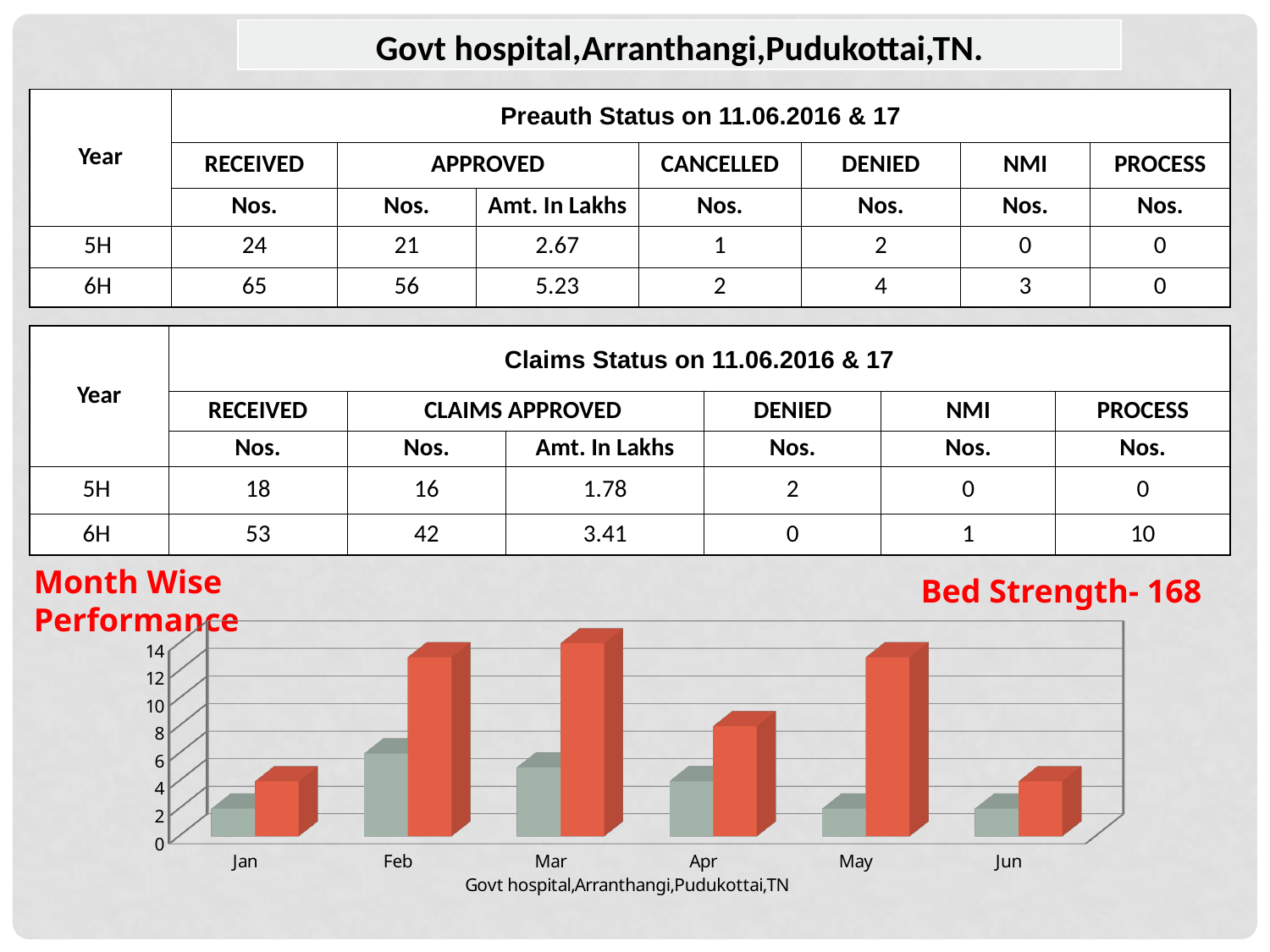
In the Month Wise Performance chart, is the red bar for Jan greater or less than 6? less In the Month Wise Performance chart, is the red bar for May greater or less than 10? greater In the Month Wise Performance chart, is the red bar for Apr greater or less than 10? less How many months are shown on the x axis of the Month Wise Performance chart? 6 What kind of chart is shown at the bottom of the slide? bar chart How many series of bars are plotted for each month in the Month Wise Performance chart? 2 In the Month Wise Performance chart, which is larger, the red bar for Feb or the red bar for Apr? Feb In the Month Wise Performance chart, which is larger, the grey bar for Feb or the grey bar for Jan? Feb What is the title shown in red above the chart? Month Wise Performance What text appears below the x axis of the chart? Govt hospital,Arranthangi,Pudukottai,TN